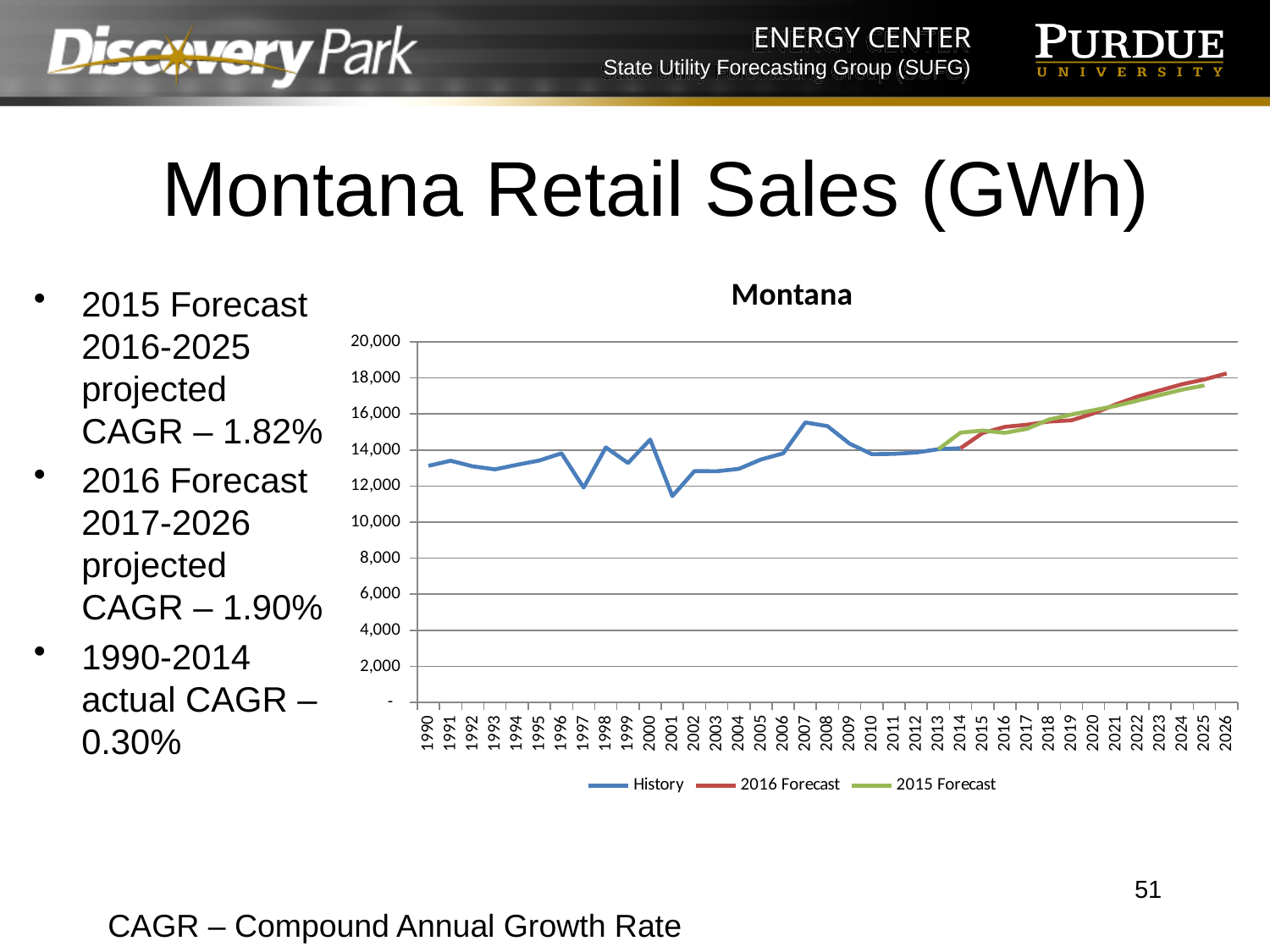
Is the History value for 1990 greater or less than 12,000? greater How many series does the chart legend list? 3 Do the forecast lines rise or fall from 2015 to 2026? rise How many years are labeled on the x axis of the chart? 37 What kind of chart is shown on the slide? line chart Is the History value for 2007 greater or less than 14,000? greater Which series is drawn in red in the chart? 2016 Forecast Which series extends furthest to the right, ending in 2026? 2016 Forecast Is the 2015 Forecast value for 2025 greater or less than 16,000? greater What is the title of the chart? Montana